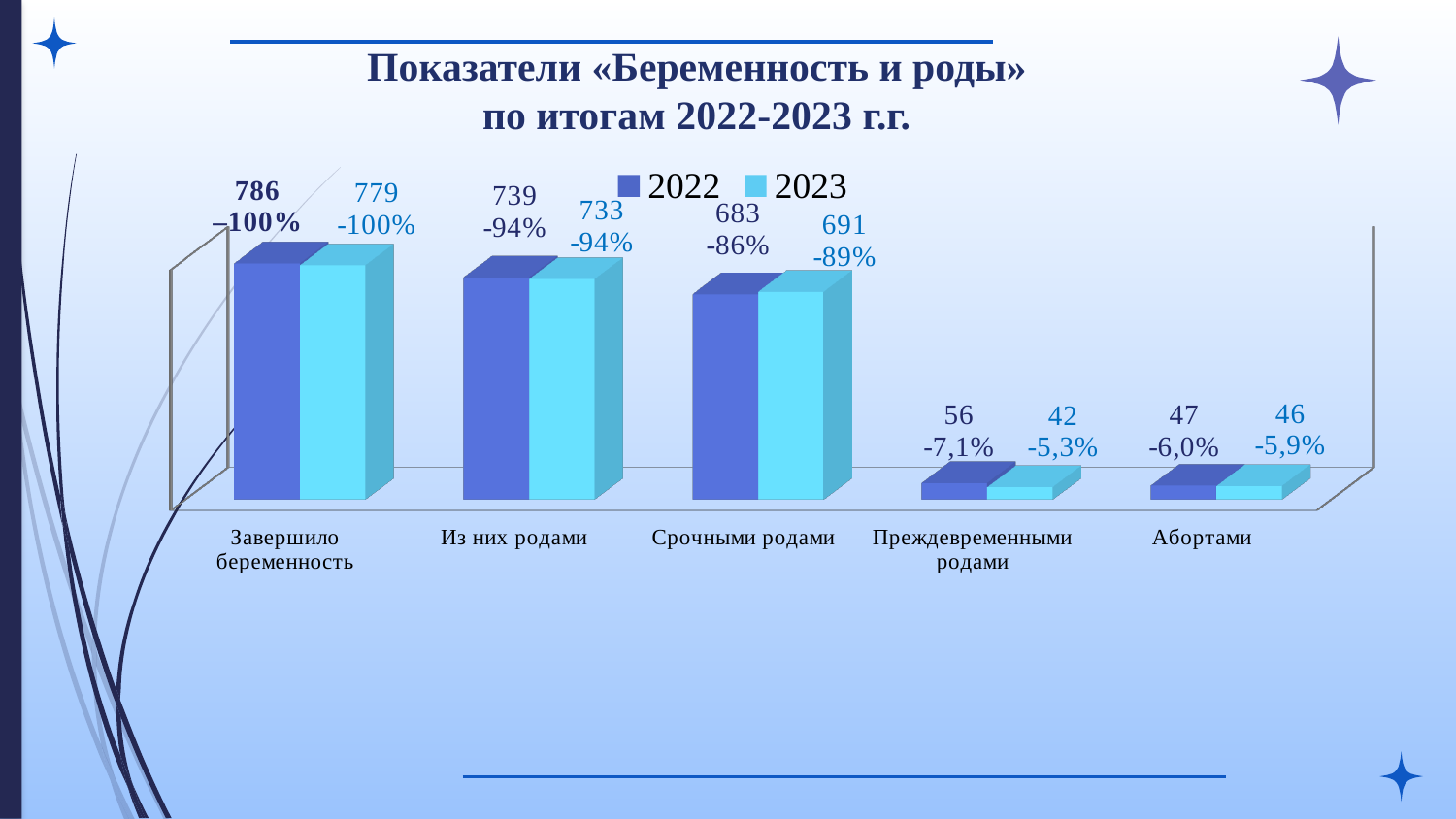
What is the 2022 value for «Завершило беременность»? 786 How many series does the legend list? 2 How many categories are shown on the x axis? 5 For «Срочными родами», which year has the larger value, 2022 or 2023? 2023 What is the difference between the 2022 and 2023 values for «Преждевременными родами»? 14 What kind of chart is shown on the slide? Bar chart What percentage is shown for «Абортами» in 2022? -6,0% Which category has the highest 2022 value? Завершило беременность Which category has the lowest 2023 value? Преждевременными родами What is the 2023 value for «Срочными родами»? 691 What is the difference between the 2022 and 2023 values for «Завершило беременность»? 7 What is the 2023 value for «Преждевременными родами»? 42